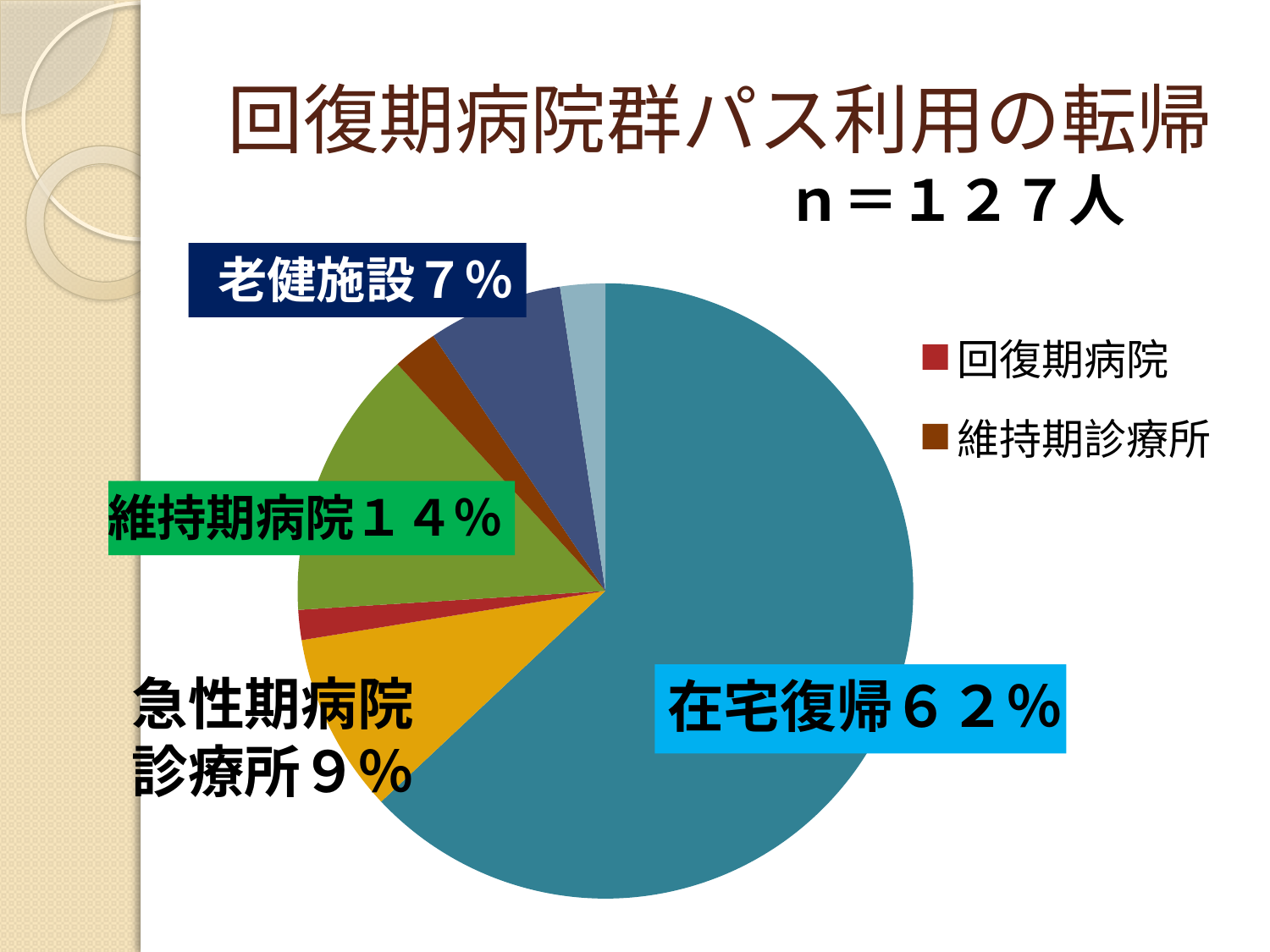
How many percentage points larger is the 維持期病院 share than the 老健施設 share? 7 What kind of chart is shown on the slide? pie chart What share of the pie is labelled 在宅復帰? ６２％ Which is larger, the share for 維持期病院 or the share for 急性期病院診療所? 維持期病院 What share of the pie is labelled 急性期病院診療所? ９％ What is the sample size (n) stated on the slide? １２７人 How many percentage points larger is the 在宅復帰 share than the 維持期病院 share? 48 Which category has the largest slice of the pie? 在宅復帰 What share of the pie is labelled 維持期病院? １４％ Which is larger, the share for 老健施設 or the share for 急性期病院診療所? 急性期病院診療所 What share of the pie is labelled 老健施設? ７％ How many slices does the pie chart have? 7